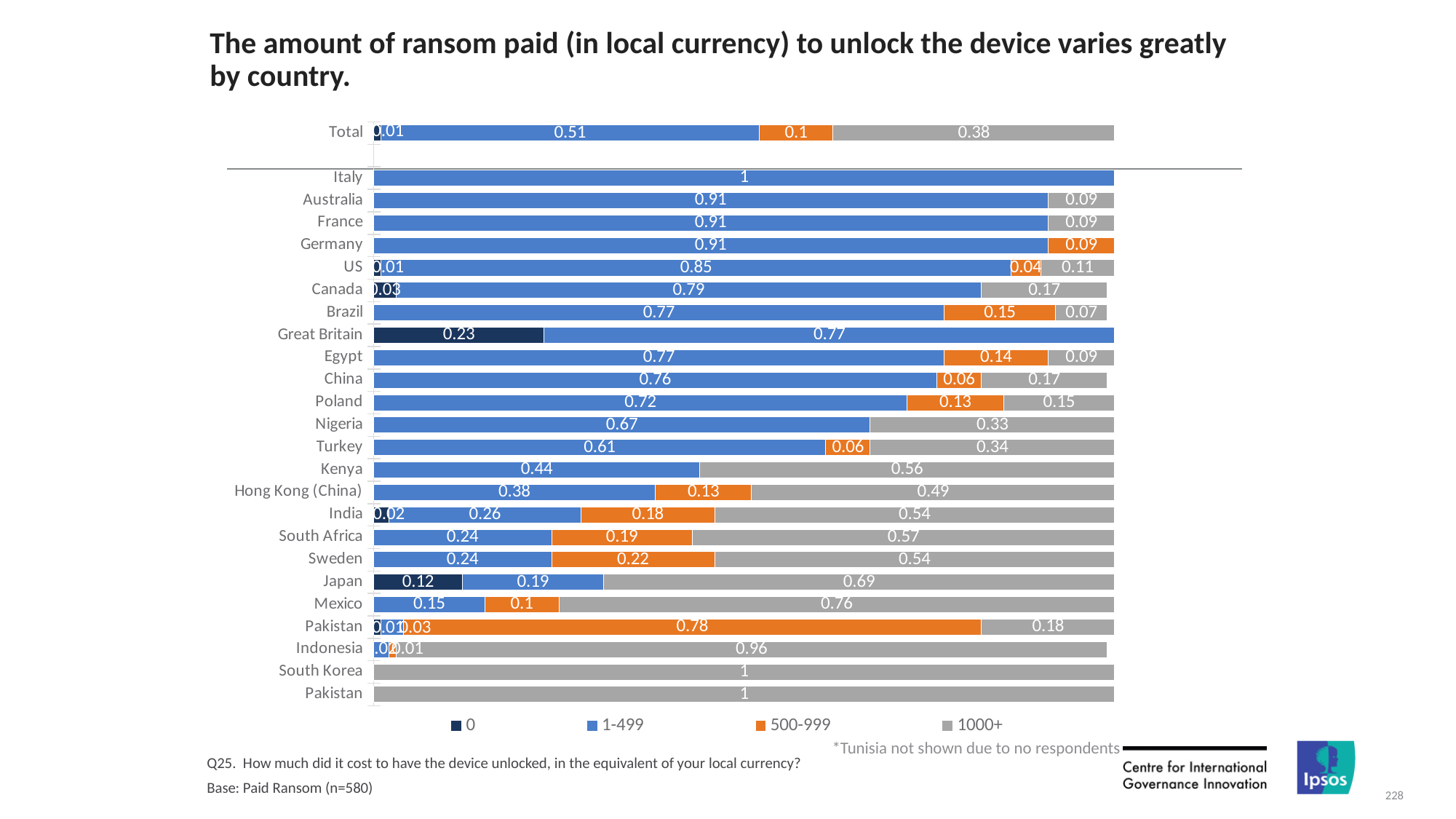
What is the value of the 1-499 segment for Total? 0.51 What kind of chart is shown on the slide? Stacked bar chart What are the legend entries of the chart? 0, 1-499, 500-999, 1000+ What is the value of the 0 segment for Great Britain? 0.23 What is the value of the 500-999 segment for Germany? 0.09 Which is larger, the 1-499 segment for Kenya or the 1-499 segment for Hong Kong (China)? Kenya How many series does the legend list? 4 Which country has the largest 0 segment? Great Britain What is the value of the 500-999 segment for Sweden? 0.22 What is the difference between the 1000+ segment for Mexico and the 1000+ segment for Japan? 0.07 What is the difference between the 1000+ segment and the 500-999 segment for Total? 0.28 What is the value of the 1000+ segment for Kenya? 0.56